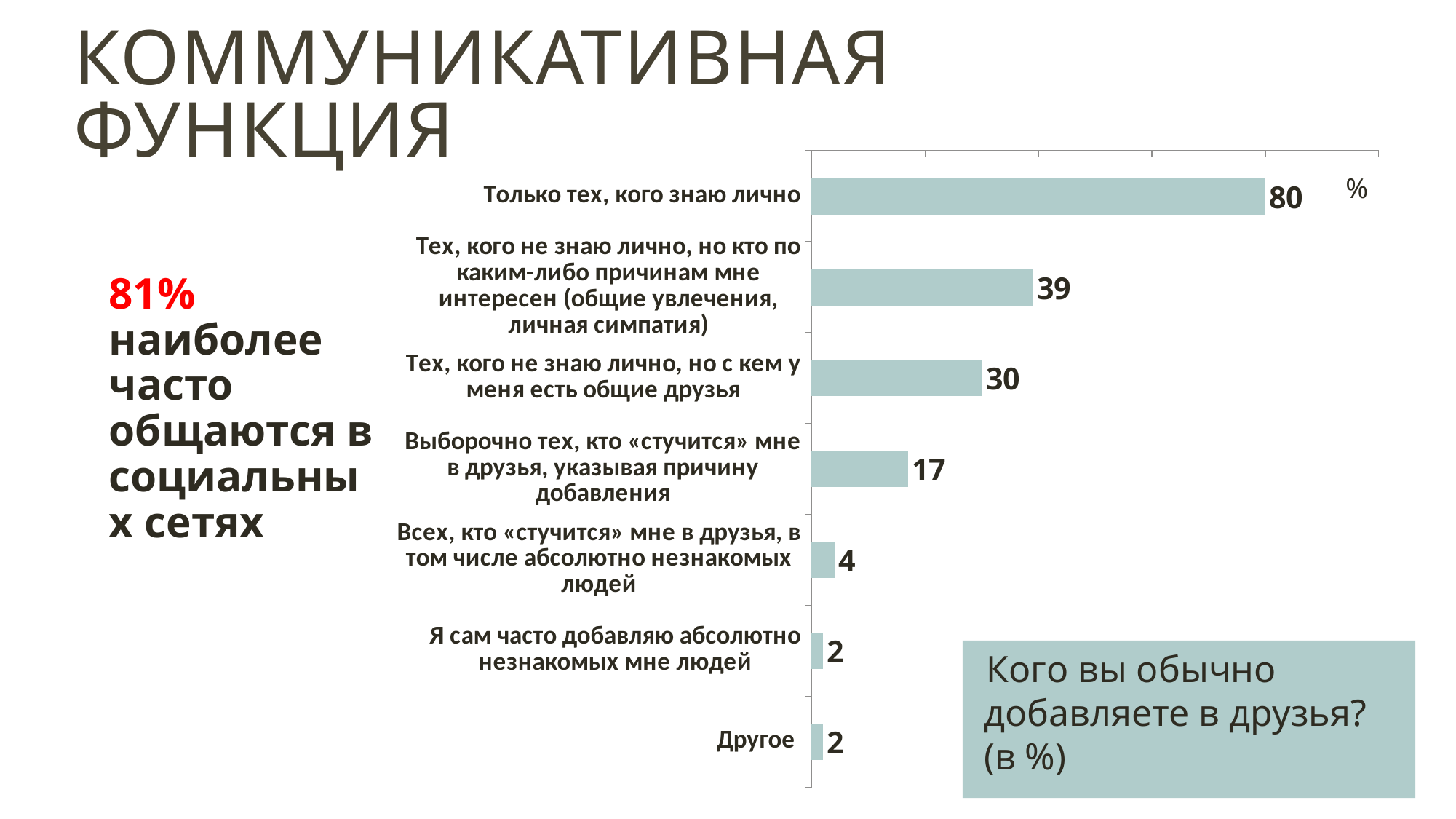
What question does the chart answer, according to the text box on the slide? Кого вы обычно добавляете в друзья? (в %) What is the difference between the values for "Только тех, кого знаю лично" and "Тех, кого не знаю лично, но кто по каким-либо причинам мне интересен (общие увлечения, личная симпатия)"? 41 What is the value for "Другое"? 2 What is the value for "Всех, кто «стучится» мне в друзья, в том числе абсолютно незнакомых людей"? 4 What is the value for "Выборочно тех, кто «стучится» мне в друзья, указывая причину добавления"? 17 Which category has the highest value? Только тех, кого знаю лично What is the value for "Только тех, кого знаю лично"? 80 What is the difference between the values for "Тех, кого не знаю лично, но с кем у меня есть общие друзья" and "Всех, кто «стучится» мне в друзья, в том числе абсолютно незнакомых людей"? 26 How many categories does the chart show? 7 Which is larger: the value for "Тех, кого не знаю лично, но с кем у меня есть общие друзья" or the value for "Выборочно тех, кто «стучится» мне в друзья, указывая причину добавления"? Тех, кого не знаю лично, но с кем у меня есть общие друзья What is the value for "Тех, кого не знаю лично, но с кем у меня есть общие друзья"? 30 What kind of chart is shown on the slide? Bar chart